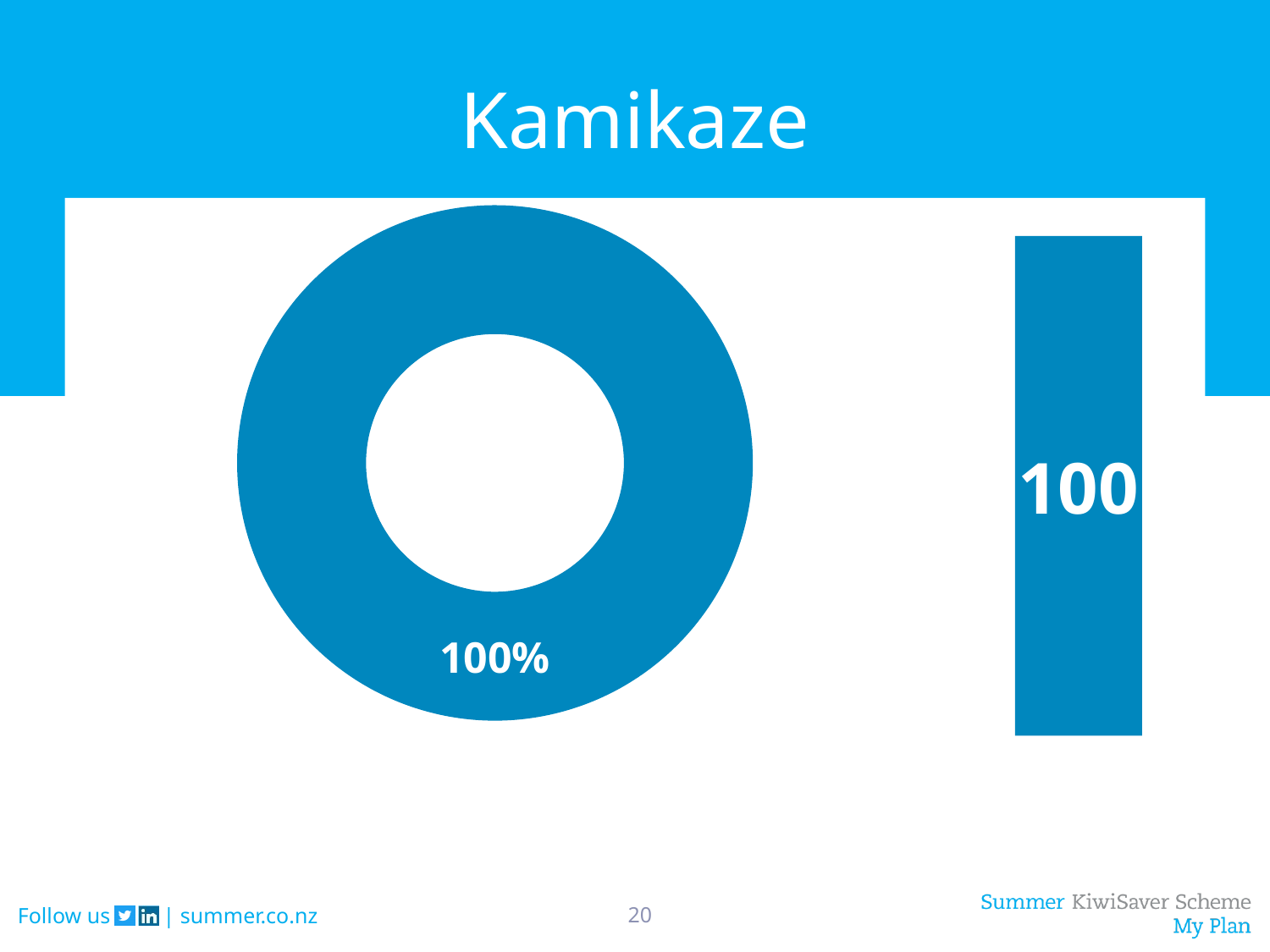
What colour is the bar in the bar chart on the right? blue What kind of chart is on the left side of the slide? doughnut chart In the doughnut chart on the left, what share of the whole does the single slice represent? 100% How many slices does the doughnut chart on the left have? 1 In the bar chart on the right, what value is printed on the bar? 100 In the doughnut chart on the left, what percentage is printed on the slice? 100% What kind of chart is on the right side of the slide? bar chart What is the title shown at the top of the slide above the charts? Kamikaze How many bars does the bar chart on the right have? 1